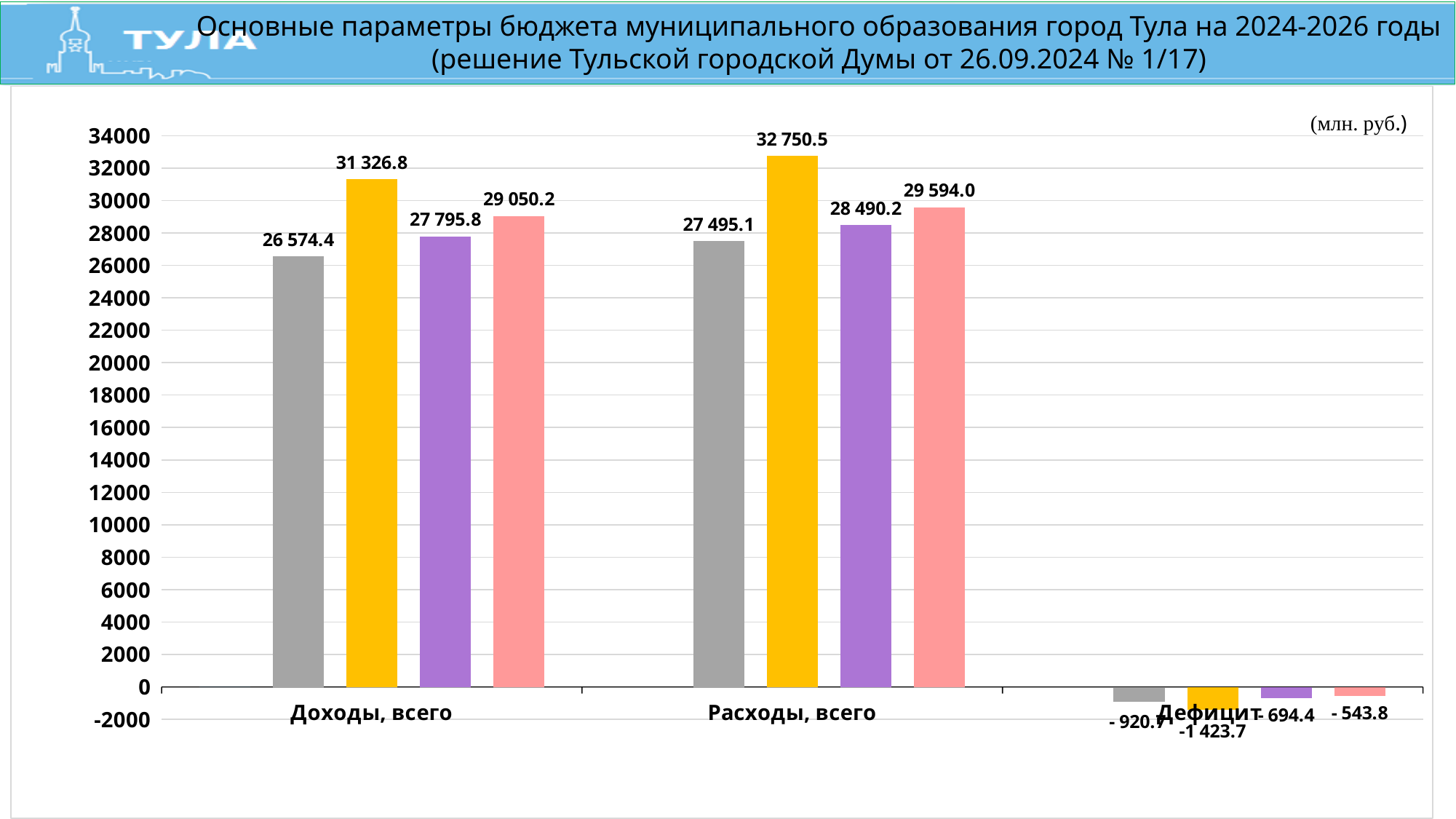
Which bar in the Расходы, всего group has the highest value? the yellow bar (32 750.5) Which is larger: the purple bar for Доходы, всего or the purple bar for Расходы, всего? the purple bar for Расходы, всего Which bar in the Доходы, всего group has the lowest value? the grey bar (26 574.4) What is the value of the yellow bar for Доходы, всего? 31 326.8 What is the value of the grey bar for Расходы, всего? 27 495.1 What is the value of the purple bar for Расходы, всего? 28 490.2 What is the value of the yellow bar for Дефицит? -1 423.7 What is the difference between the yellow bar for Расходы, всего and the yellow bar for Доходы, всего? 1 423.7 What kind of chart is shown on the slide? bar chart What unit of measurement is indicated in the top right corner of the chart? млн. руб. How many categories are shown on the x axis? 3 What is the value of the pink bar for Доходы, всего? 29 050.2